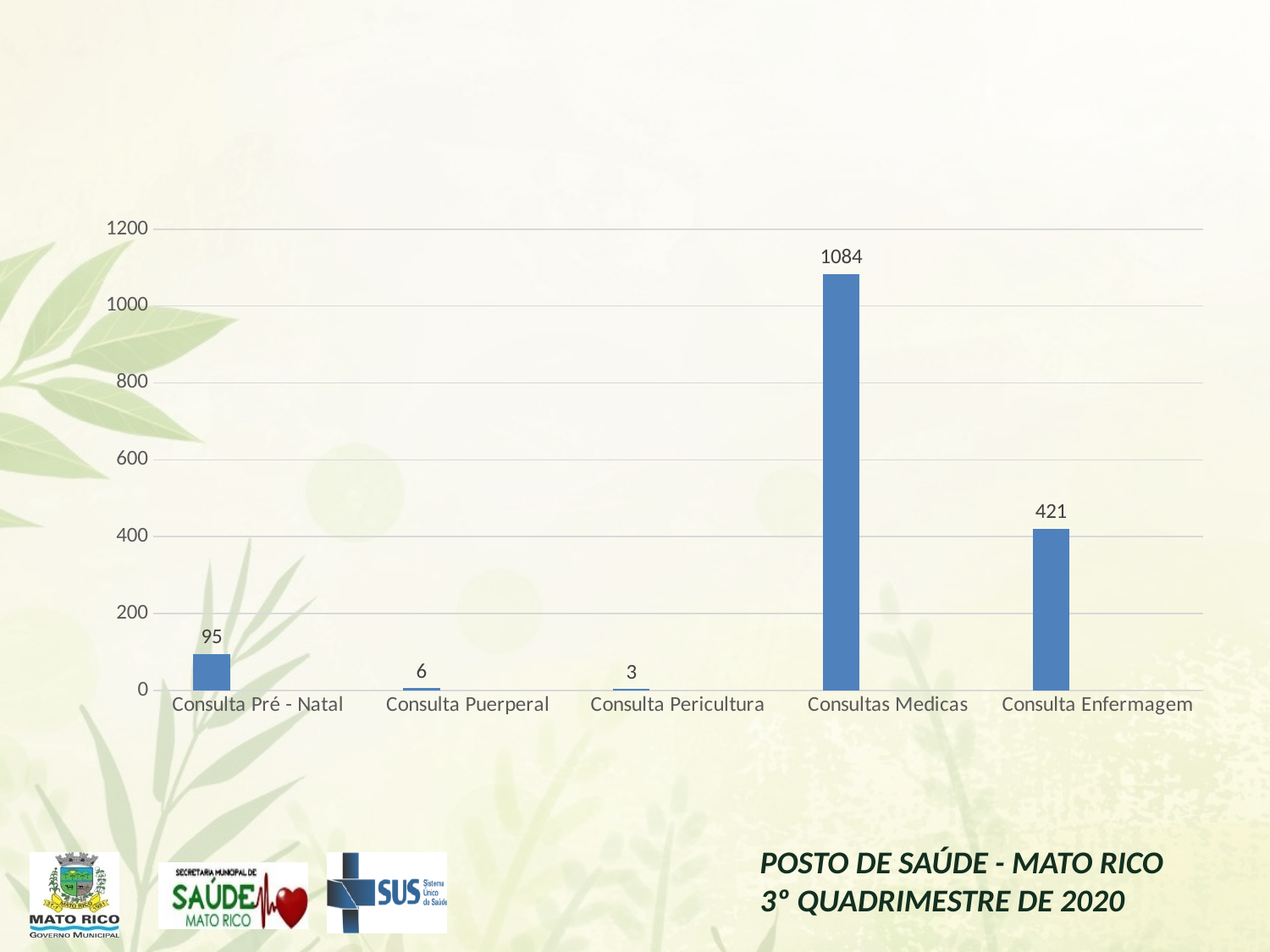
Which category has the highest value? Consultas Medicas What is the value for Consulta Enfermagem? 421 What is the value for Consulta Puerperal? 6 What is the highest value shown on the vertical axis? 1200 How many categories are shown on the x axis? 5 What is the value for Consulta Pré - Natal? 95 What kind of chart is shown on the slide? bar chart Which is larger, Consulta Pré - Natal or Consulta Puerperal? Consulta Pré - Natal Which category has the lowest value? Consulta Pericultura What is the value for Consultas Medicas? 1084 Is the value for Consulta Enfermagem greater or less than 400? greater What is the difference between Consultas Medicas and Consulta Enfermagem? 663